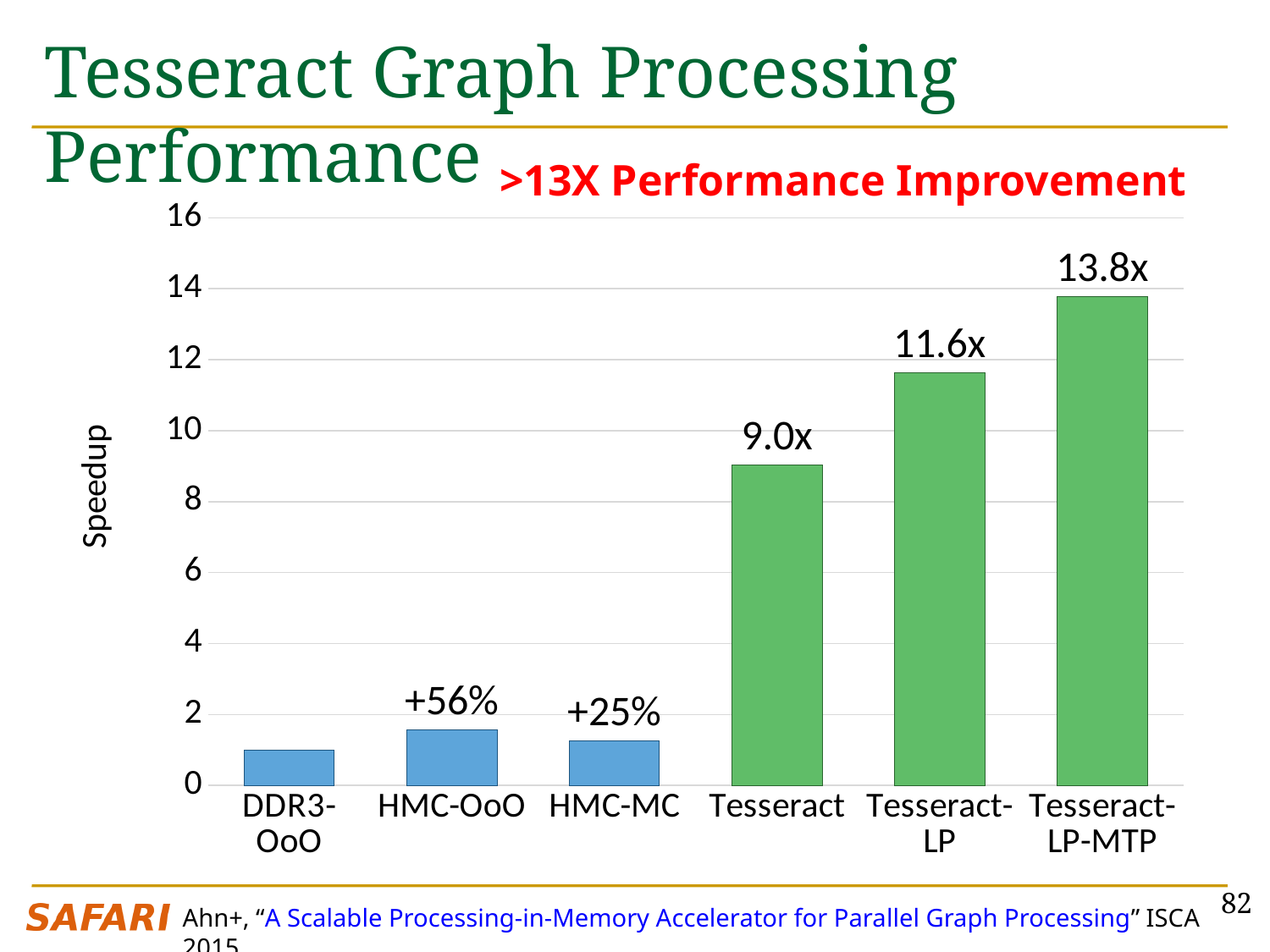
Which category has the lowest speedup? DDR3-OoO What kind of chart is shown on the slide? bar chart What is the speedup value labelled for Tesseract-LP-MTP? 13.8x What is the speedup value labelled for Tesseract? 9.0x What label is printed above the HMC-MC bar? +25% How many categories are shown on the x axis of the chart? 6 Is the speedup for DDR3-OoO greater or less than 2? less What is the label on the y axis of the chart? Speedup Which category has the highest speedup? Tesseract-LP-MTP What is the difference between the speedup of Tesseract-LP-MTP and Tesseract-LP? 2.2x What label is printed above the HMC-OoO bar? +56% What is the speedup value labelled for Tesseract-LP? 11.6x